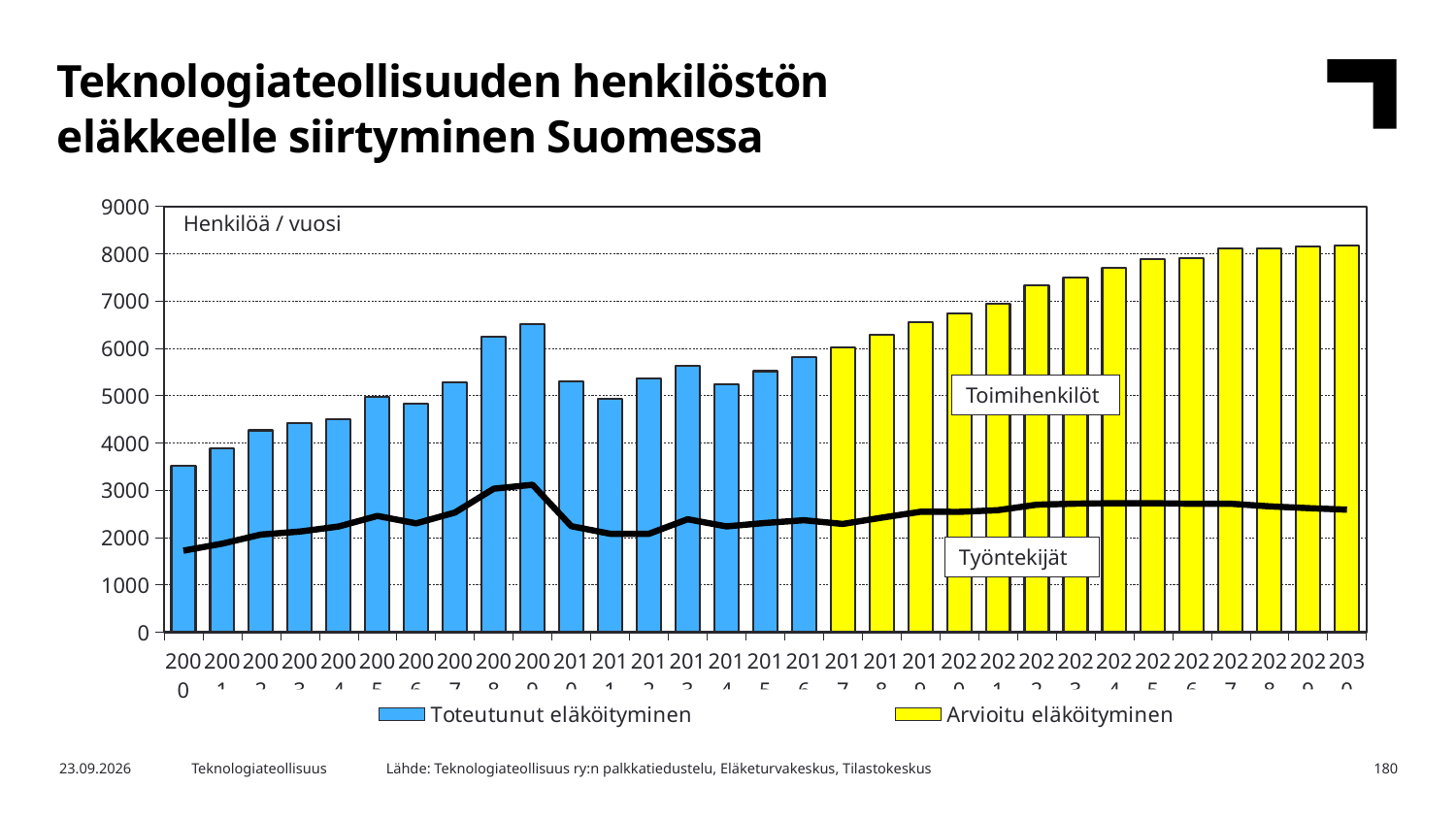
How many years (bars) are plotted along the x axis? 31 What are the two series named in the legend? Toteutunut eläköityminen and Arvioitu eläköityminen What kind of chart is shown on the slide? bar and line chart Which bar is taller, 2009 or 2010? 2009 Is the bar for 2030 greater or less than 8000? greater Which year has the lowest bar? 2000 How many series does the legend list? 2 Is the bar for 2020 greater or less than 6000? greater Is the bar for 2000 greater or less than 4000? less Do the Arvioitu eläköityminen bars rise or fall from 2017 to 2030? rise What unit label is shown inside the plot area at the top left? Henkilöä / vuosi